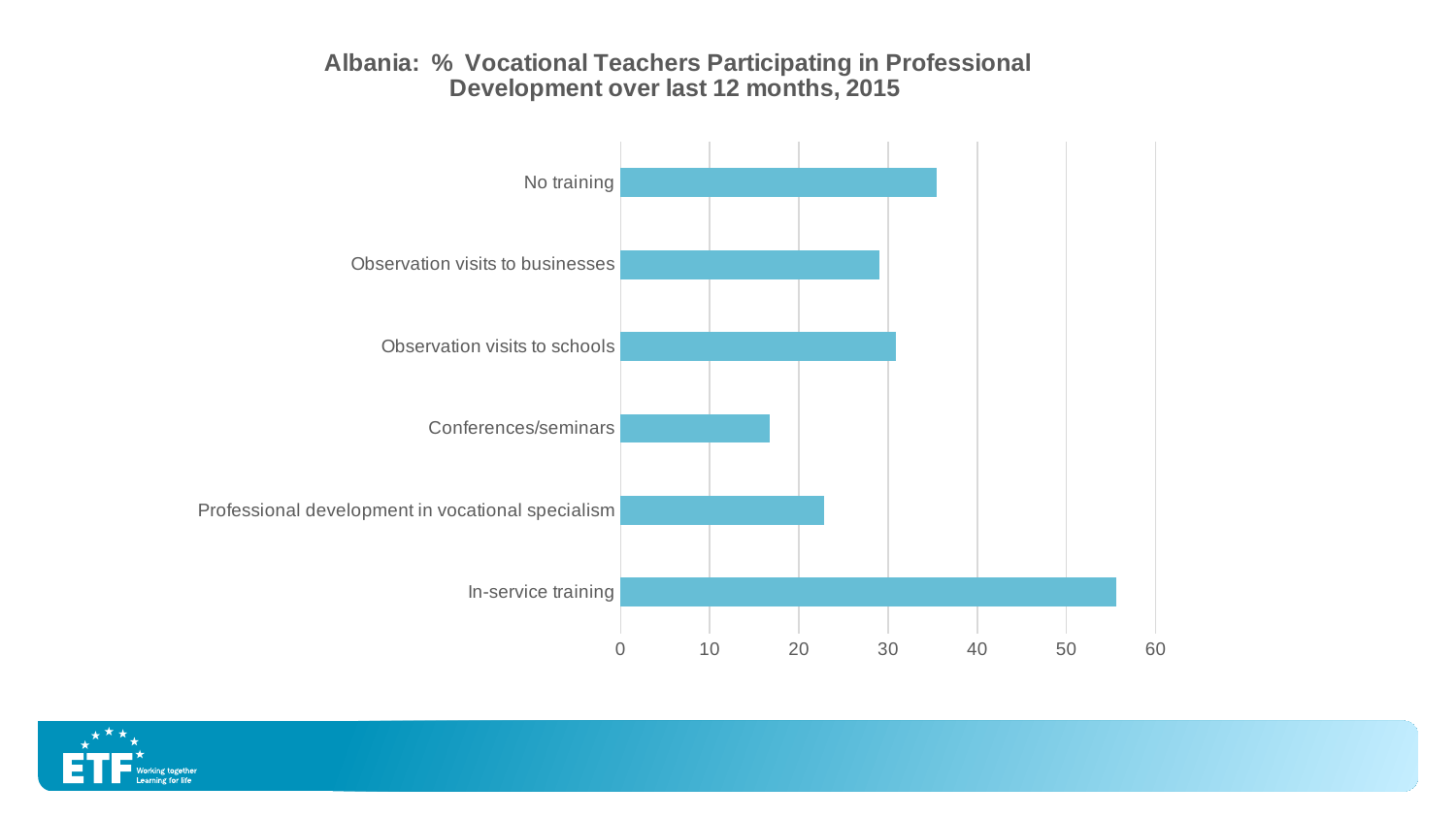
Is the value for Conferences/seminars greater or less than 20? less Which category has the lowest value? Conferences/seminars Is the value for Observation visits to schools greater or less than 40? less What kind of chart is shown on the slide? bar chart Is the value for No training greater or less than 30? greater Which is larger, the value for In-service training or the value for No training? In-service training Which category has the highest value? In-service training Which is larger, the value for Conferences/seminars or the value for Professional development in vocational specialism? Professional development in vocational specialism Which year does the chart title say the data refers to? 2015 How many categories are plotted in the chart? 6